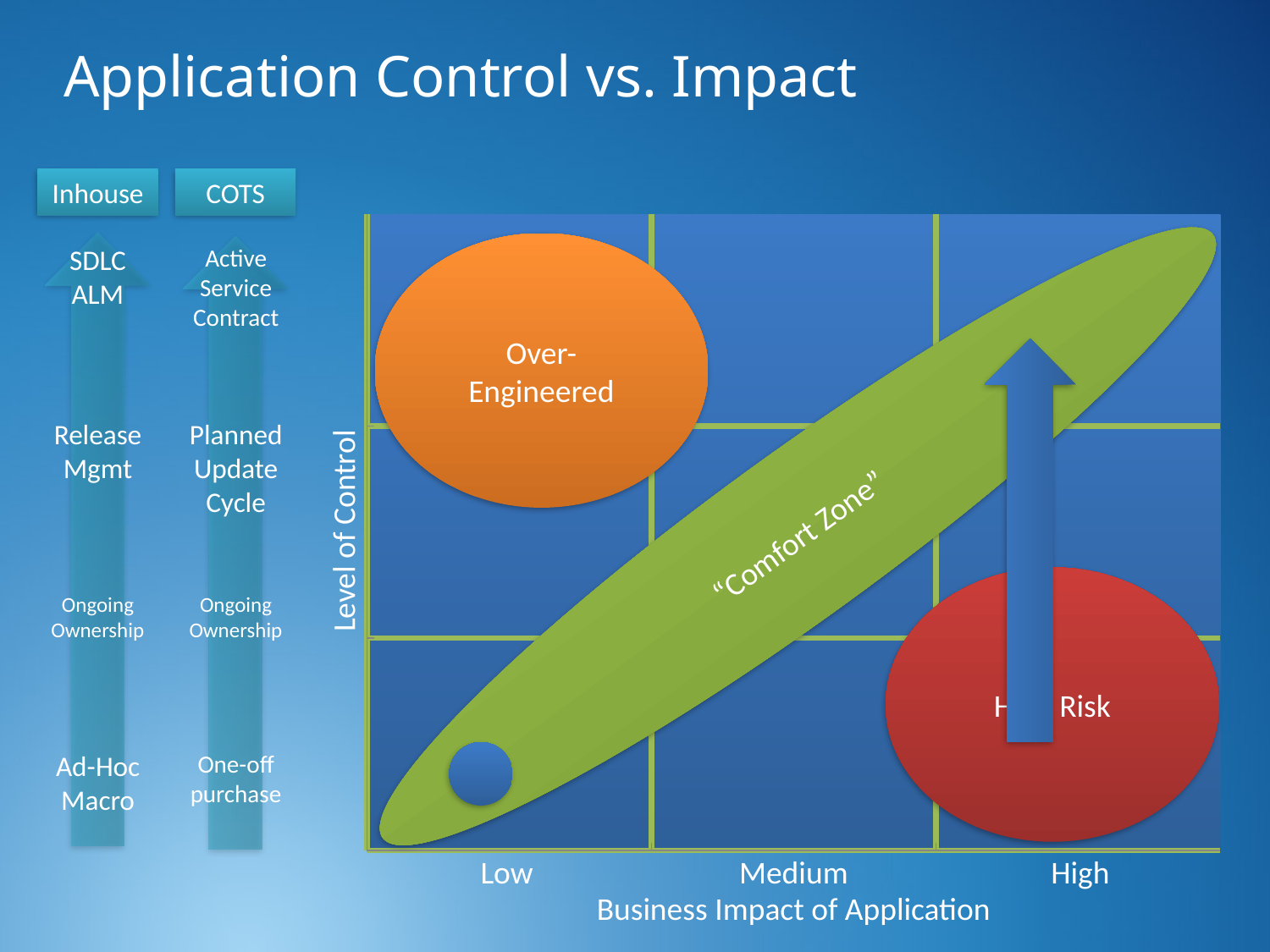
How many categories are shown along the horizontal axis of the chart? 3 Does the green 'Comfort Zone' band rise or fall as business impact increases from Low to High? rise Which horizontal-axis category does the orange 'Over-Engineered' region sit above? Low What is the label of the vertical axis of the chart? Level of Control Which horizontal-axis category does the red 'High Risk' region sit above? High What is the label of the horizontal axis of the chart? Business Impact of Application